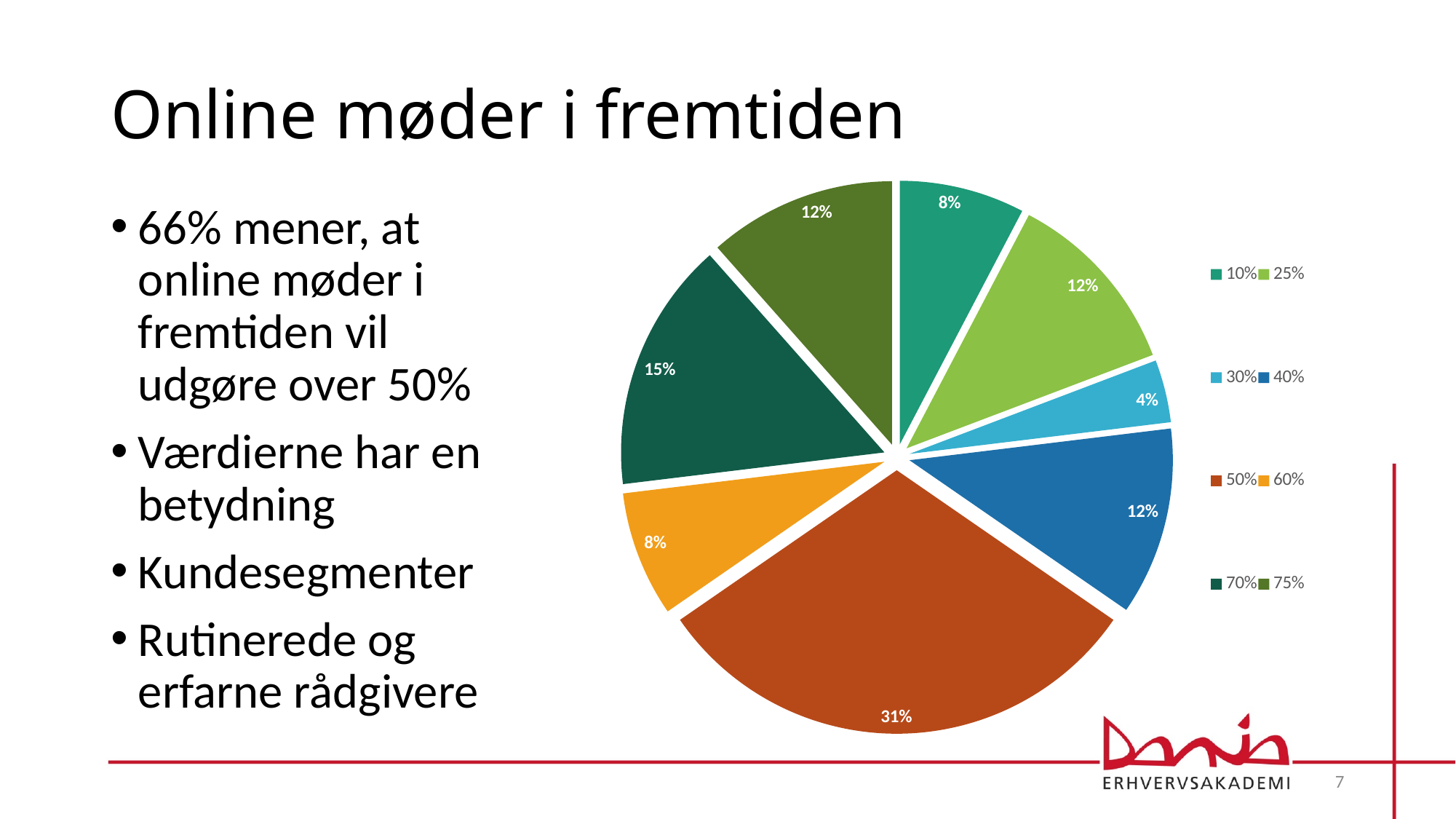
Which has the larger slice, the "60%" category or the "40%" category? 40% How many slices does the pie chart have? 8 What kind of chart is shown on the slide? pie chart What share of the pie does the "70%" category take? 15% What share of the pie does the "10%" category take? 8% What colour is the slice for the "60%" category? orange What is the difference between the share for "50%" and the share for "70%"? 16% Which category has the largest slice of the pie? 50% What share of the pie does the "30%" category take? 4% How many entries does the legend list? 8 Which category has the smallest slice of the pie? 30%